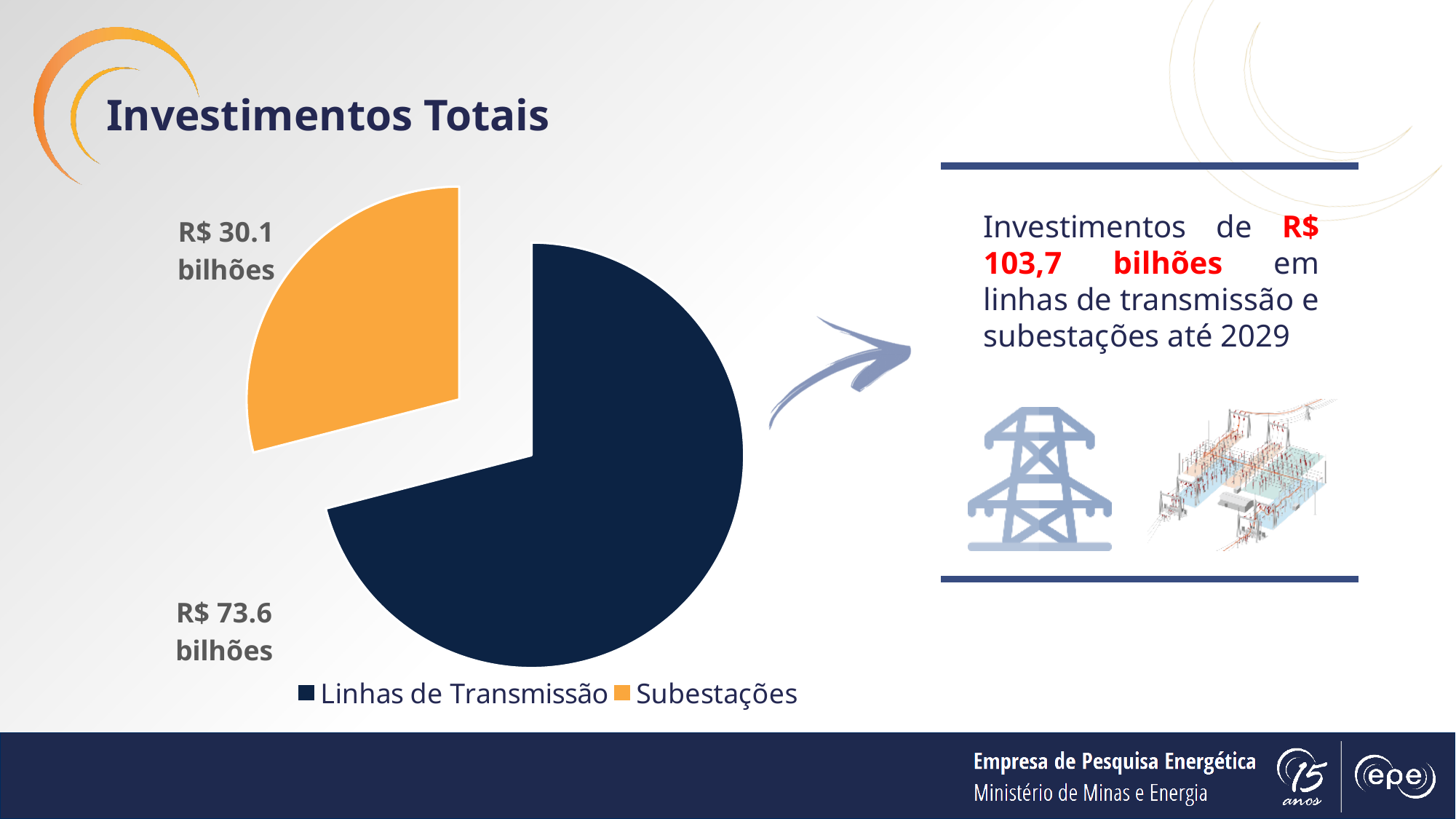
Which category has the smallest slice of the pie? Subestações What is the total of the two slices in the pie chart? R$ 103.7 bilhões What kind of chart is shown on the slide? Pie chart How many entries does the legend list? 2 What colour is the Subestações slice? Orange What is the value for Linhas de Transmissão? R$ 73.6 bilhões How many slices does the pie chart have? 2 What is the difference between the values for Linhas de Transmissão and Subestações? R$ 43.5 bilhões What is the value for Subestações? R$ 30.1 bilhões Which is larger, the value for Linhas de Transmissão or the value for Subestações? Linhas de Transmissão Which category has the largest slice of the pie? Linhas de Transmissão